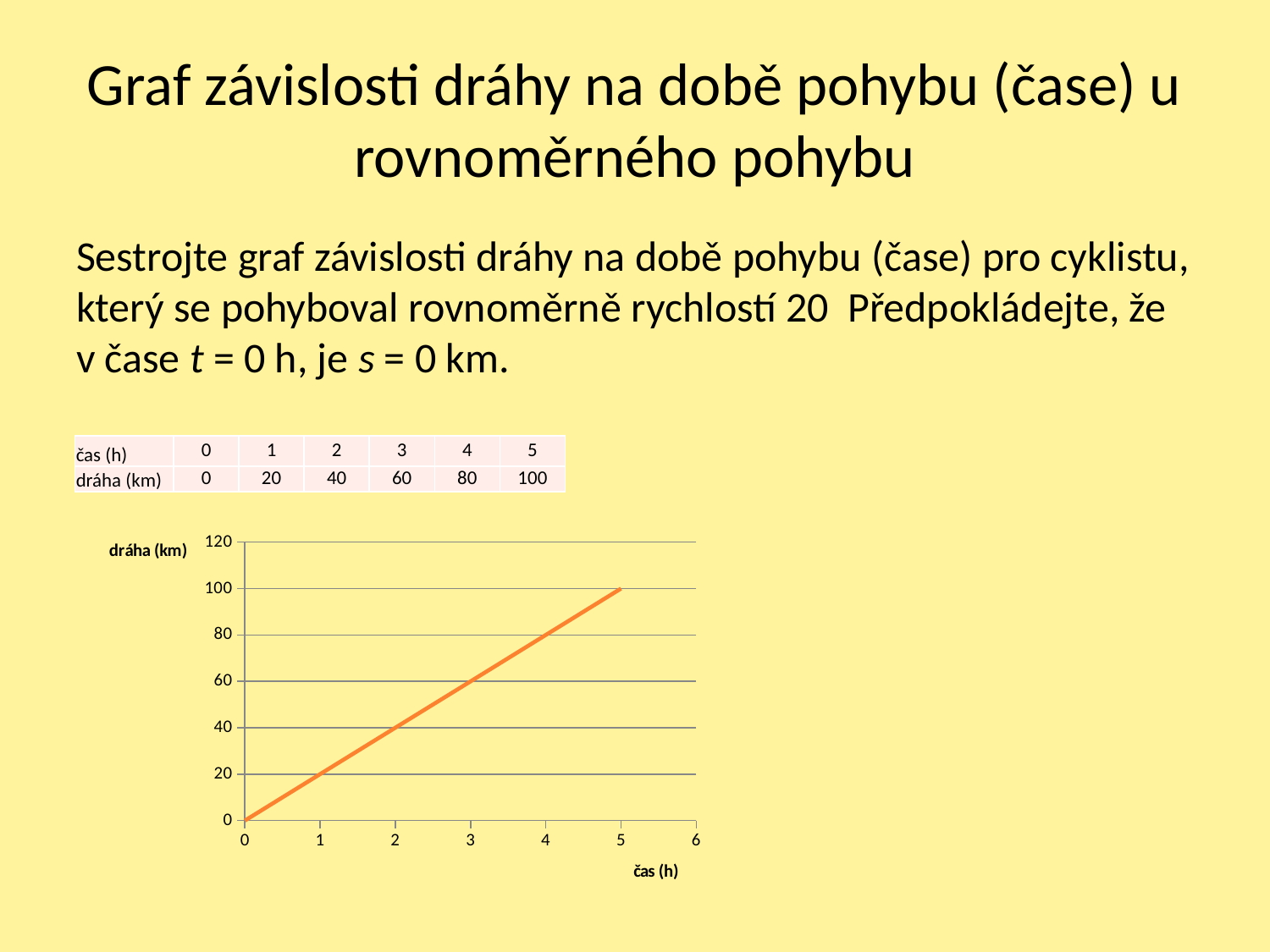
What is the value of dráha (km) at čas = 3 h? 60 What is the difference in dráha (km) between čas = 4 h and čas = 2 h? 40 What kind of chart is shown on the slide? line chart At which value of čas (h) is dráha (km) lowest? 0 Does dráha (km) rise or fall as čas (h) increases? rise What is the value of dráha (km) at čas = 1 h? 20 What is the label of the vertical axis of the chart? dráha (km) Which is larger: dráha at čas = 2 h or dráha at čas = 4 h? čas = 4 h What is the label of the horizontal axis of the chart? čas (h) Is the value of dráha at čas = 5 h greater or less than 120? less At which value of čas (h) does the line reach its highest dráha value? 5 What is the value of dráha (km) at čas = 5 h? 100